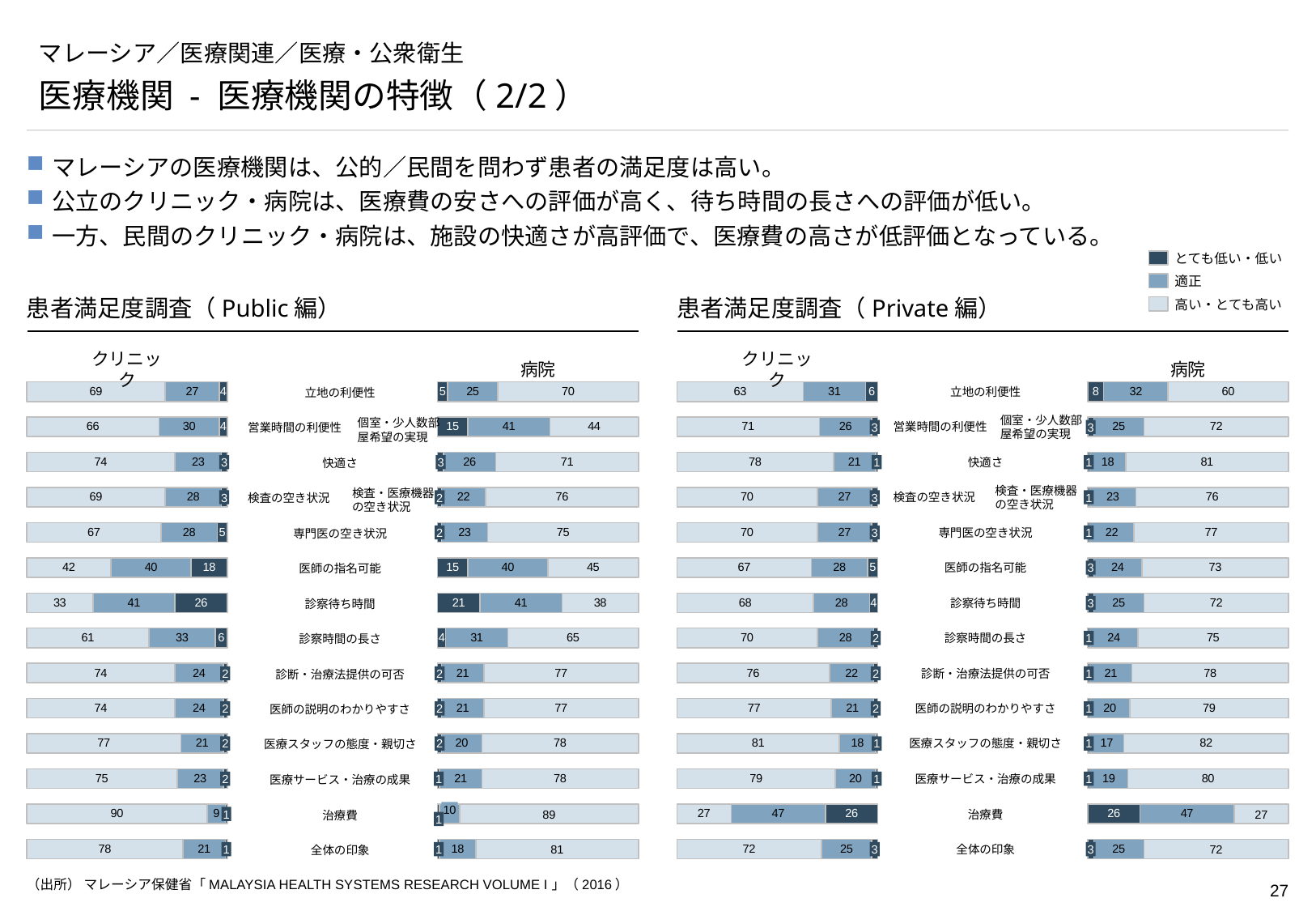
In the Public クリニック chart, which category has the highest 高い・とても高い value? 治療費 In the Private クリニック chart, what is the 適正 value for 治療費? 47 In the Private 病院 chart, which category has the lowest 高い・とても高い value? 治療費 How many series does the legend list for the satisfaction charts? 3 In the Private 病院 chart, what is the 高い・とても高い value for 快適さ? 81 In the Public クリニック chart, what is the 高い・とても高い value for 治療費? 90 What kind of chart is used in the 患者満足度調査（Public 編） section? stacked bar chart In the Private クリニック chart, what is the total of the stacked bar for 立地の利便性? 100 In the Public 病院 chart, which is larger: the 高い・とても高い value for 診察待ち時間 or for 医師の指名可能? 医師の指名可能 How many categories are shown in the Public クリニック chart? 14 In the Public 病院 chart, what is the とても低い・低い value for 診察待ち時間? 21 In the Public クリニック chart, what is the difference between the とても低い・低い values for 診察待ち時間 and 医師の指名可能? 8